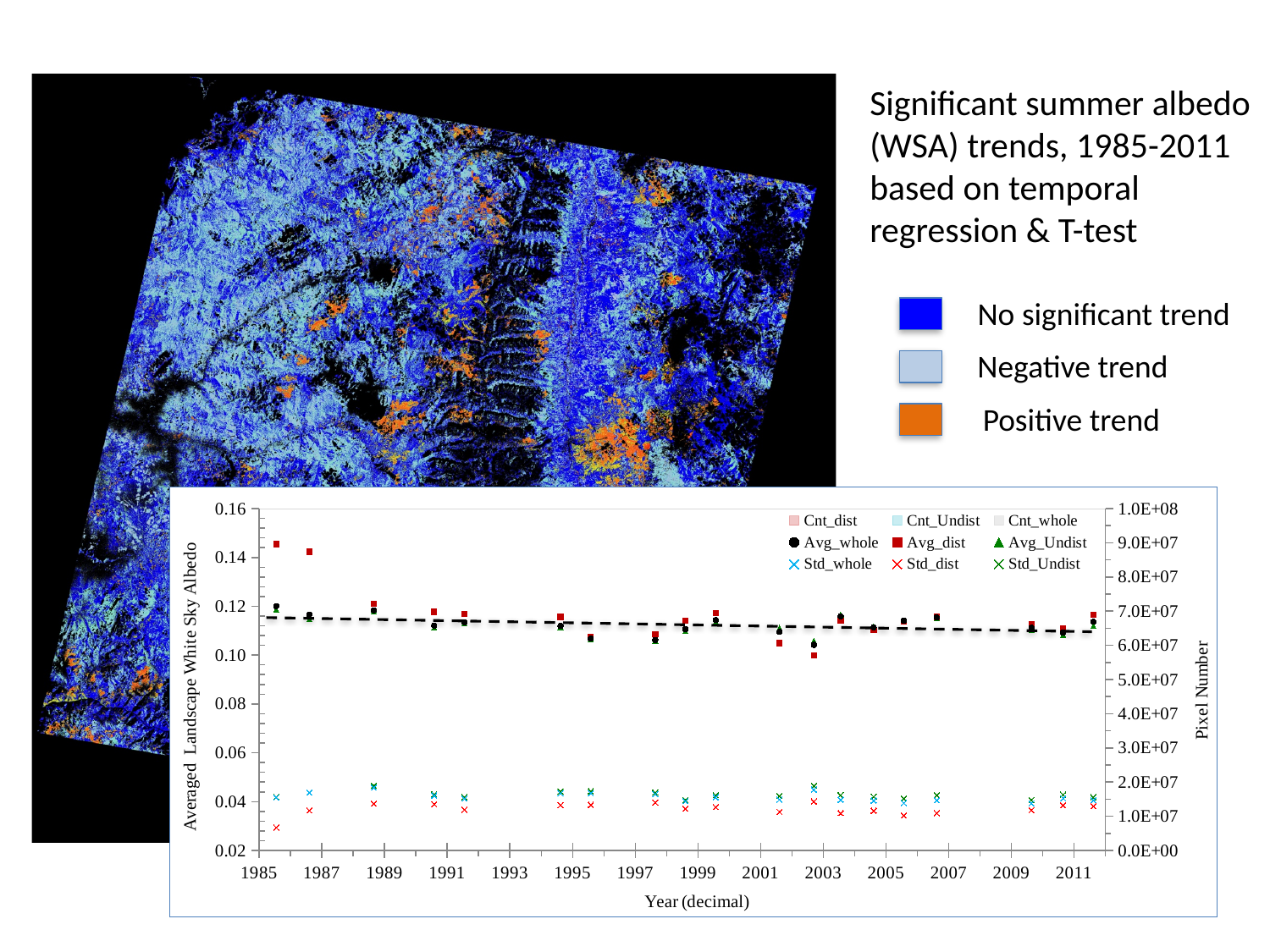
What is the maximum value shown on the left y axis of the scatter chart? 0.16 Is the highest Avg_dist value found at the start or at the end of the time series? start Are the Std_whole values greater or less than 0.06 throughout the series? less Is the first Avg_dist value (just after 1985) greater or less than 0.14? greater How many series does the legend of the scatter chart list? 9 What kind of chart is shown at the bottom of the slide? scatter chart Is the Avg_dist value near 2003 (the lowest red square) greater or less than 0.12? less What is the title of the right-hand (secondary) y axis of the scatter chart? Pixel Number What is the title of the x axis of the scatter chart? Year (decimal) Does the dashed trend line in the scatter chart rise or fall from 1985 to 2011? fall Near 1985, which is larger: the Avg_dist value or the Avg_whole value? Avg_dist